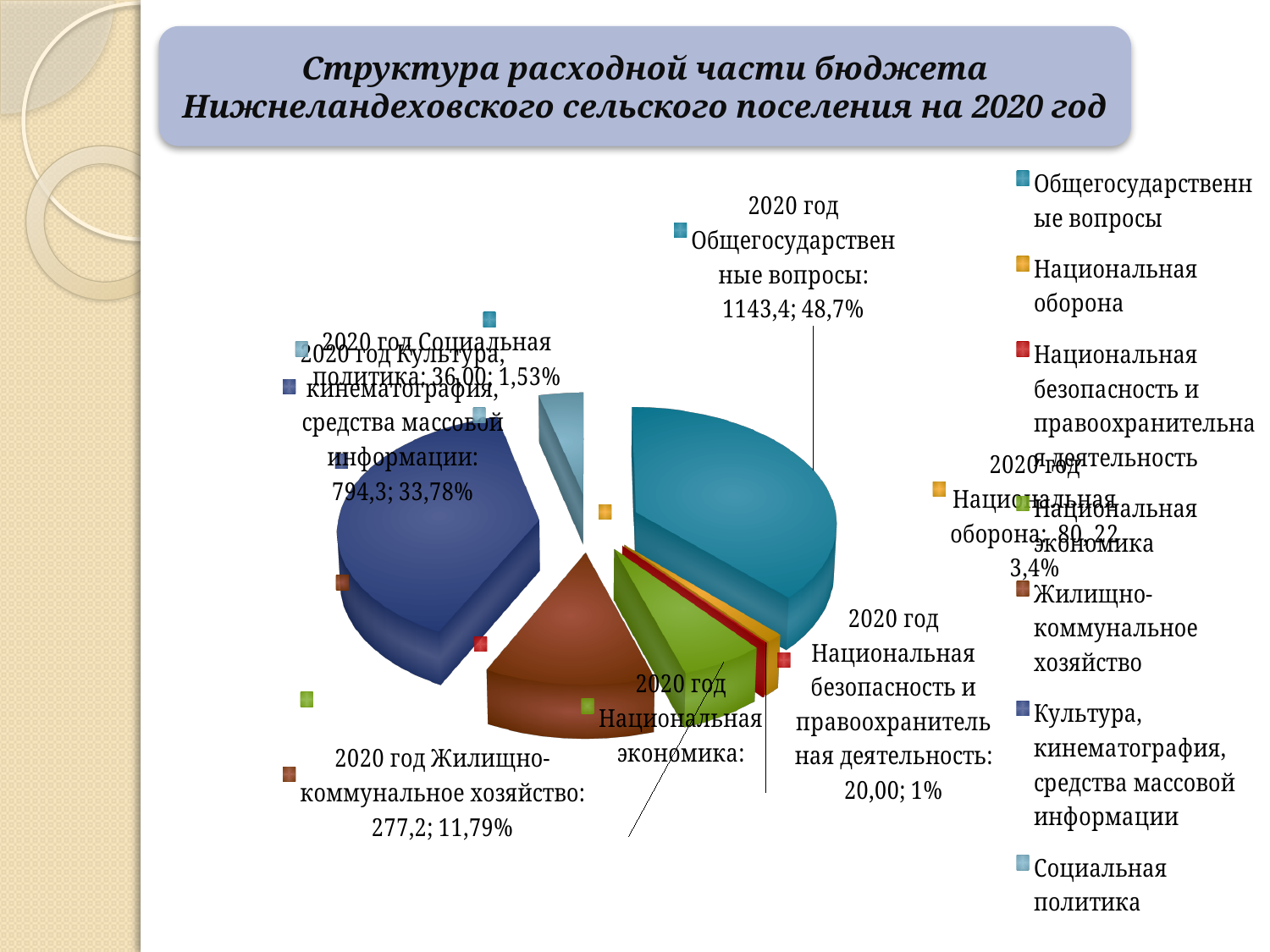
How many categories does the legend of the pie chart list? 7 What share of the pie does Культура, кинематография, средства массовой информации take? 33,78% What kind of chart is shown on the slide? pie chart What value is shown for Культура, кинематография, средства массовой информации? 794,3 What share of the pie does Жилищно-коммунальное хозяйство take? 11,79% What value is shown for Национальная безопасность и правоохранительная деятельность? 20,00 Which category has the largest slice of the pie? Общегосударственные вопросы What share of the pie does Общегосударственные вопросы take? 48,7% What value is shown for Жилищно-коммунальное хозяйство? 277,2 What is the difference between the values for Общегосударственные вопросы and Культура, кинематография, средства массовой информации? 349,1 What value is shown for Общегосударственные вопросы in the pie chart? 1143,4